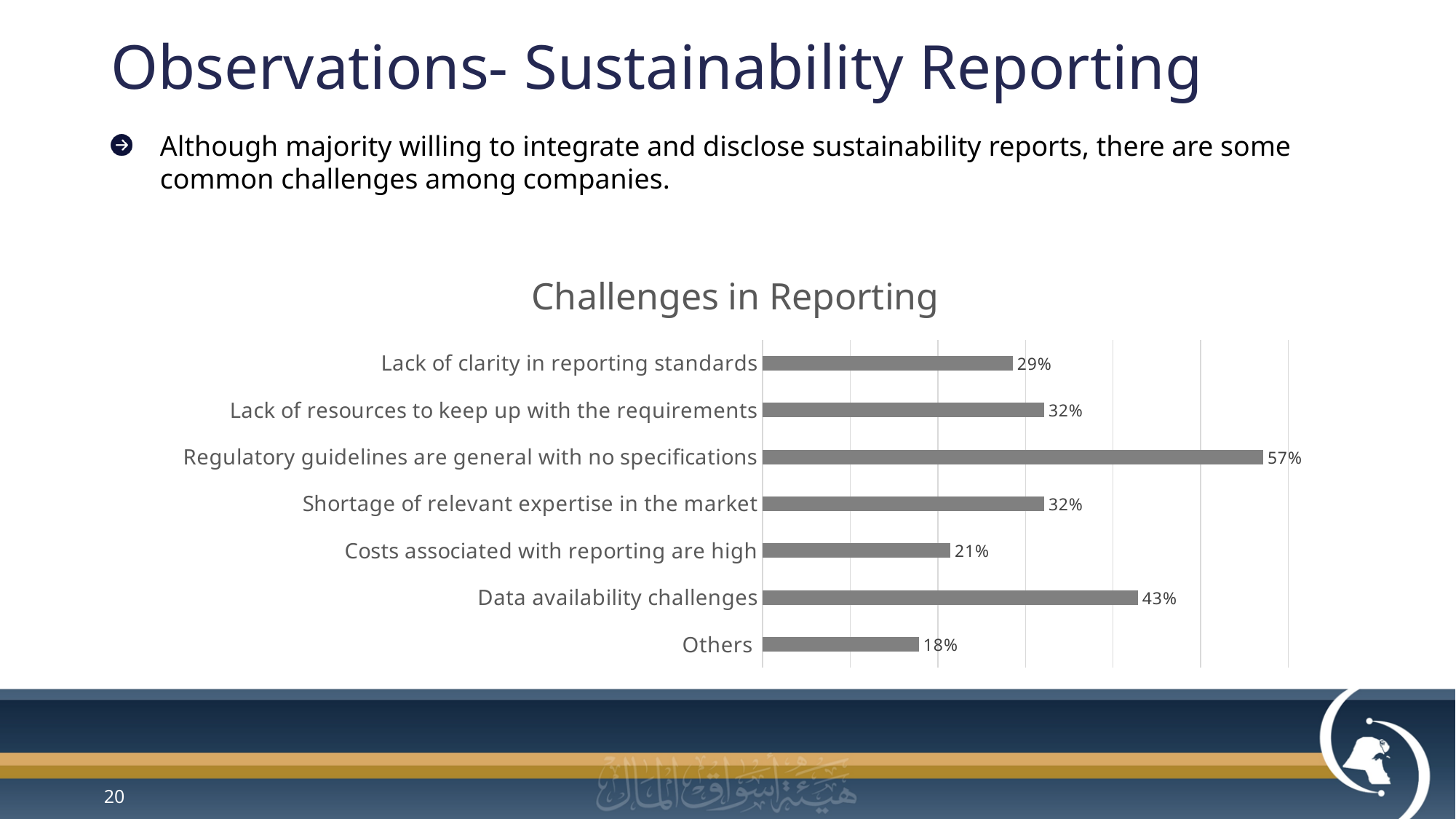
What is the value for 'Regulatory guidelines are general with no specifications'? 57% Which is larger: 'Lack of clarity in reporting standards' or 'Lack of resources to keep up with the requirements'? Lack of resources to keep up with the requirements Which category has the lowest value? Others What is the value for 'Lack of clarity in reporting standards'? 29% What is the title of the chart? Challenges in Reporting What is the difference between 'Shortage of relevant expertise in the market' and 'Others'? 14% How many categories are shown in the chart? 7 What kind of chart is shown on the slide? Bar chart What is the value for 'Costs associated with reporting are high'? 21% Which challenge has the highest value? Regulatory guidelines are general with no specifications What is the value for 'Data availability challenges'? 43% What is the difference between 'Regulatory guidelines are general with no specifications' and 'Data availability challenges'? 14%